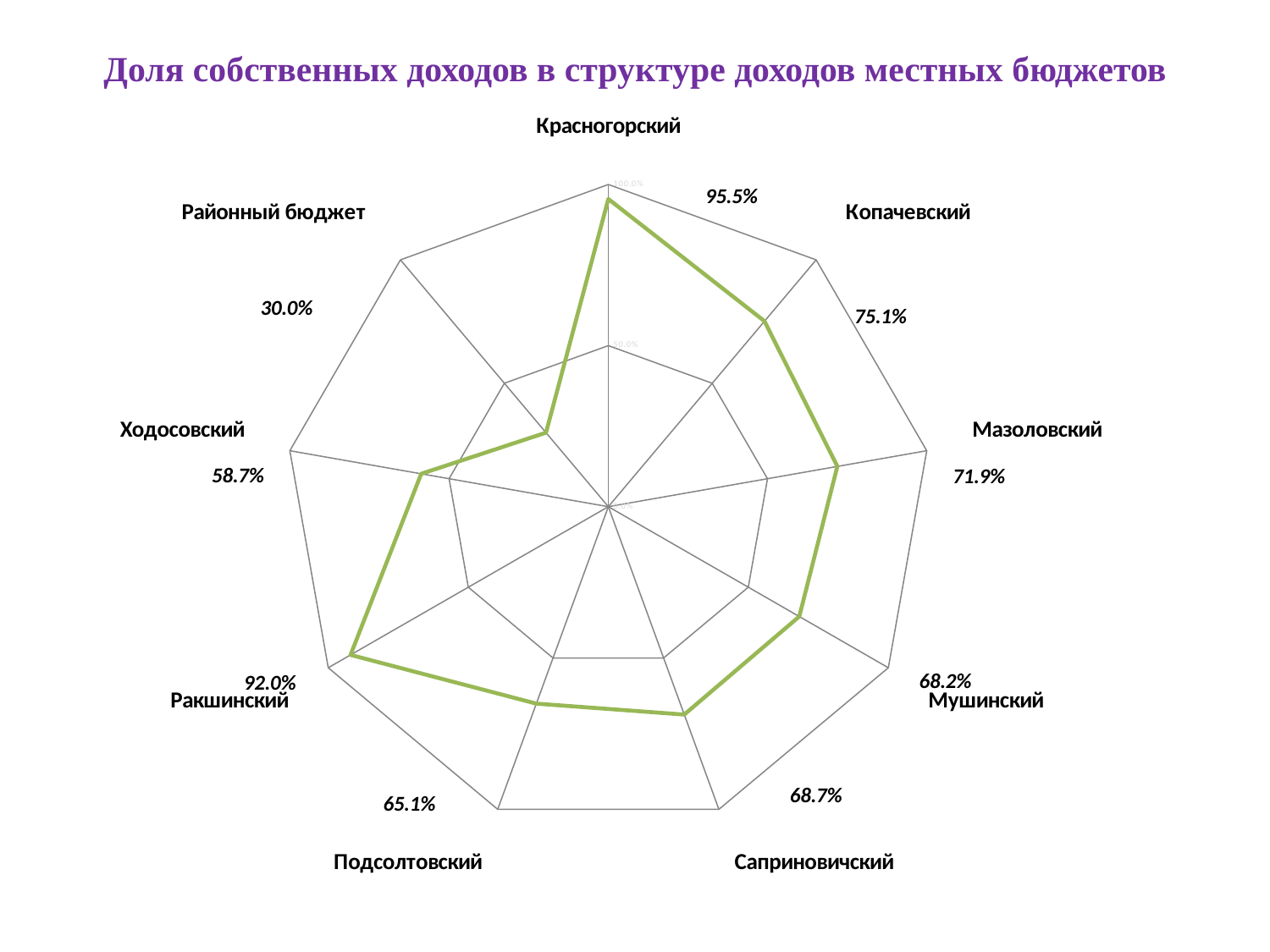
What is the value for Ходосовский? 58.7% Which category has the lowest value? Районный бюджет Which category has the highest value? Красногорский What is the value for Районный бюджет? 30.0% How many categories are plotted on the chart? 9 What is the difference between the values for Красногорский and Районный бюджет? 65.5% What is the value for Красногорский? 95.5% What is the difference between the values for Ракшинский and Подсолтовский? 26.9% What is the value for Ракшинский? 92.0% What type of chart is shown on the slide? Radar chart Which is larger, the value for Копачевский or the value for Мазоловский? Копачевский What is the title of the slide? Доля собственных доходов в структуре доходов местных бюджетов